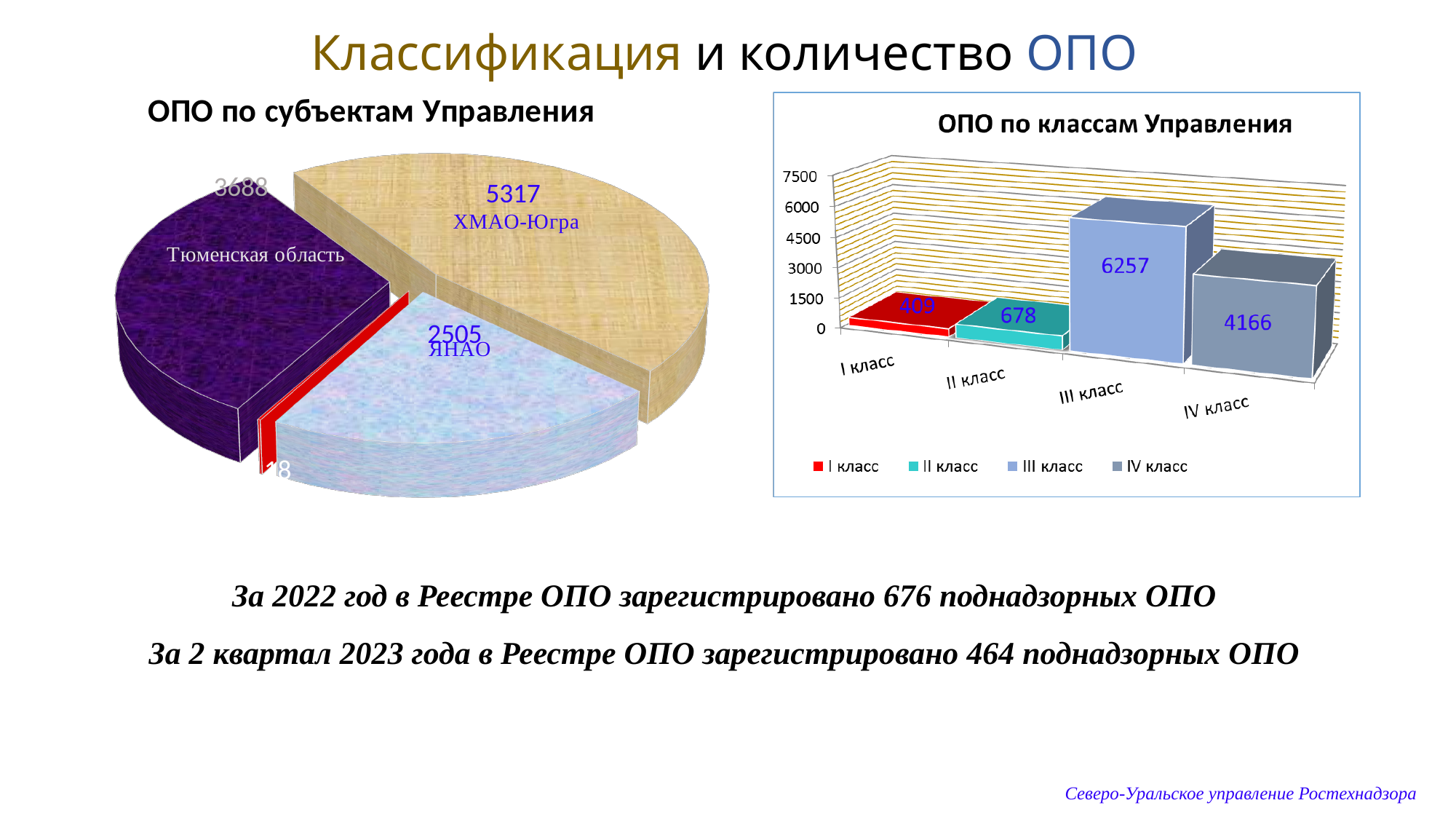
In the chart titled 'ОПО по классам Управления', which class has the highest value? III класс In the chart titled 'ОПО по классам Управления', which class has the lowest value? I класс In the chart titled 'ОПО по классам Управления', what is the value for III класс? 6257 In the chart titled 'ОПО по классам Управления', how many entries does the legend list? 4 In the chart titled 'ОПО по субъектам Управления', which of ХМАО-Югра or Тюменская область has the larger value? ХМАО-Югра What kind of chart is the one titled 'ОПО по субъектам Управления'? Pie chart In the chart titled 'ОПО по субъектам Управления', what is the value for ЯНАО? 2505 In the chart titled 'ОПО по субъектам Управления', what is the difference between the values for ХМАО-Югра and ЯНАО? 2812 In the chart titled 'ОПО по классам Управления', what is the difference between the values for III класс and IV класс? 2091 In the chart titled 'ОПО по классам Управления', what is the value for I класс? 409 In the chart titled 'ОПО по субъектам Управления', what is the value for Тюменская область? 3688 In the chart titled 'ОПО по субъектам Управления', what is the value for ХМАО-Югра? 5317